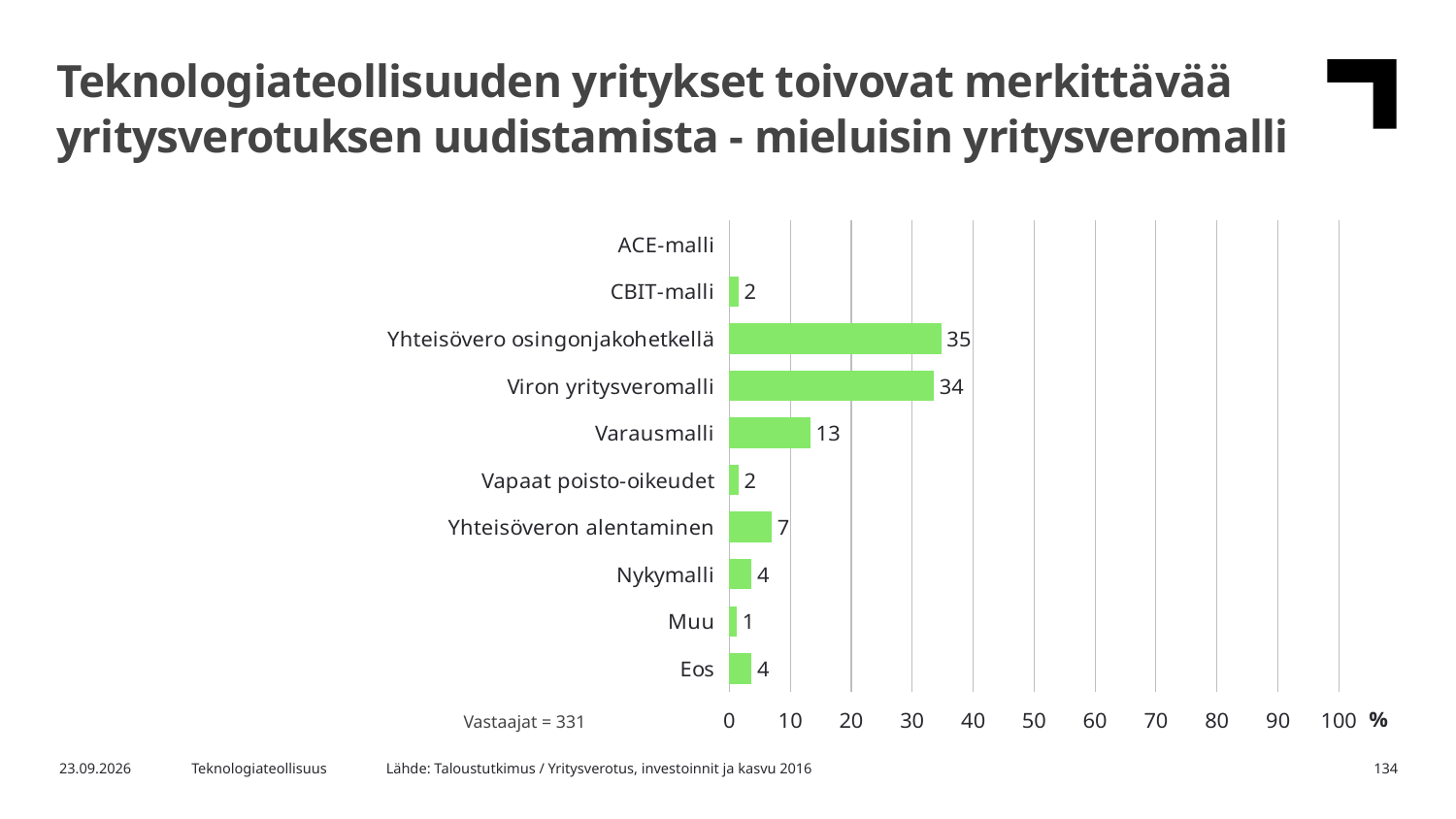
What value is shown for Yhteisövero osingonjakohetkellä? 35 What value is shown for Viron yritysveromalli? 34 What kind of chart is shown on the slide? bar chart Is the value for Yhteisövero osingonjakohetkellä greater or less than 30? greater What value is shown for Varausmalli? 13 Which category has the highest value? Yhteisövero osingonjakohetkellä What is the difference between the values for Varausmalli and Yhteisöveron alentaminen? 6 How many respondents (Vastaajat) does the chart note? 331 How many categories are shown on the chart? 10 What value is shown for Yhteisöveron alentaminen? 7 What is the difference between the values for Yhteisövero osingonjakohetkellä and Viron yritysveromalli? 1 Which is larger, the value for Varausmalli or the value for Nykymalli? Varausmalli